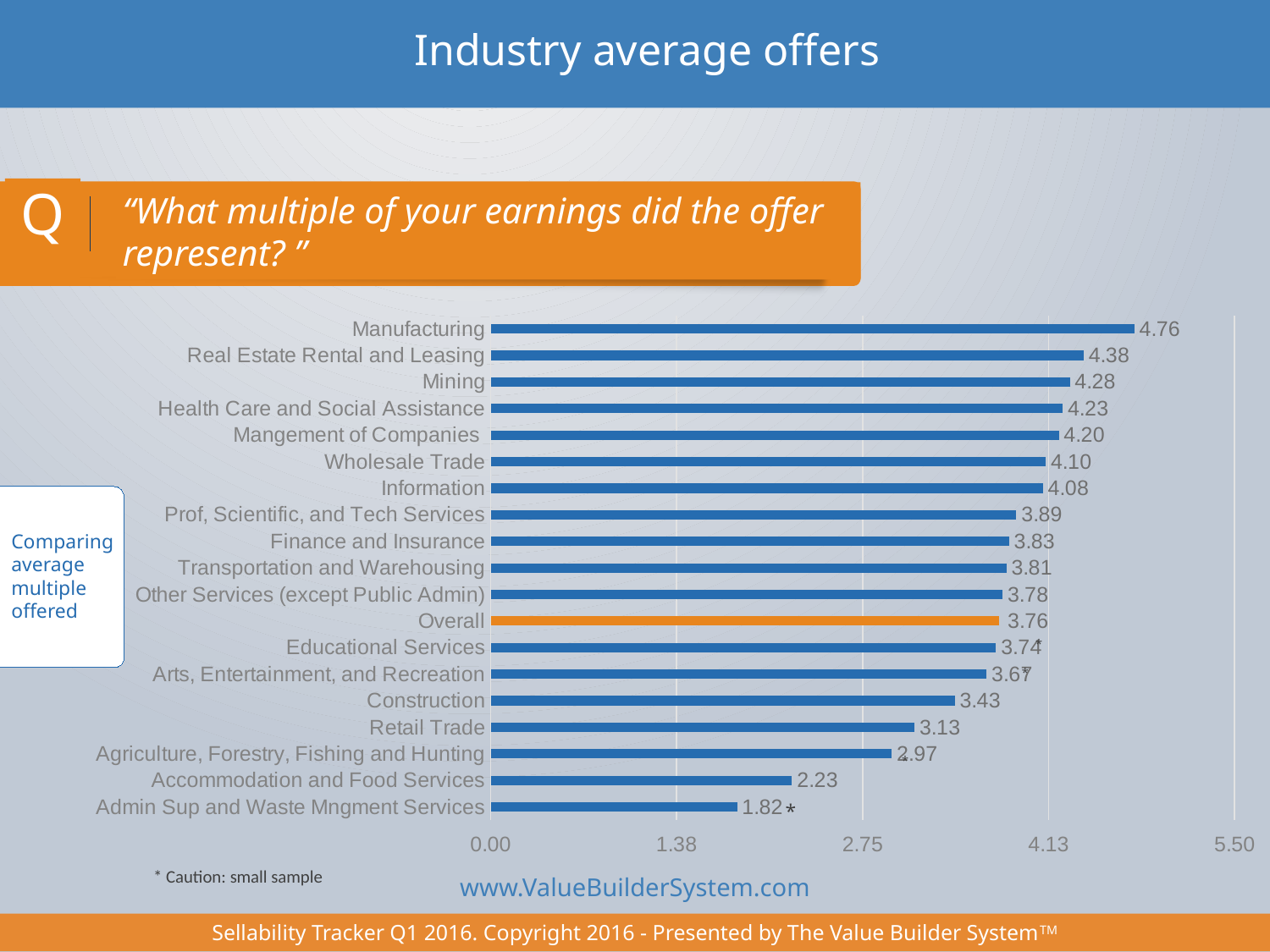
Which has a higher average multiple offered, Retail Trade or Accommodation and Food Services? Retail Trade How many bars are plotted in the chart? 19 What kind of chart is shown on the slide? Bar chart What is the average multiple offered for Construction? 3.43 Which industry has the lowest average multiple offered? Admin Sup and Waste Mngment Services What is the difference between the values for Wholesale Trade and Information? 0.02 Which bar is coloured orange instead of blue? Overall What is the difference between the values for Manufacturing and Admin Sup and Waste Mngment Services? 2.94 Is the value for Mining greater or less than 4.13? greater Which industry has the highest average multiple offered? Manufacturing What is the value shown for the Overall bar? 3.76 What is the average multiple offered for Manufacturing? 4.76